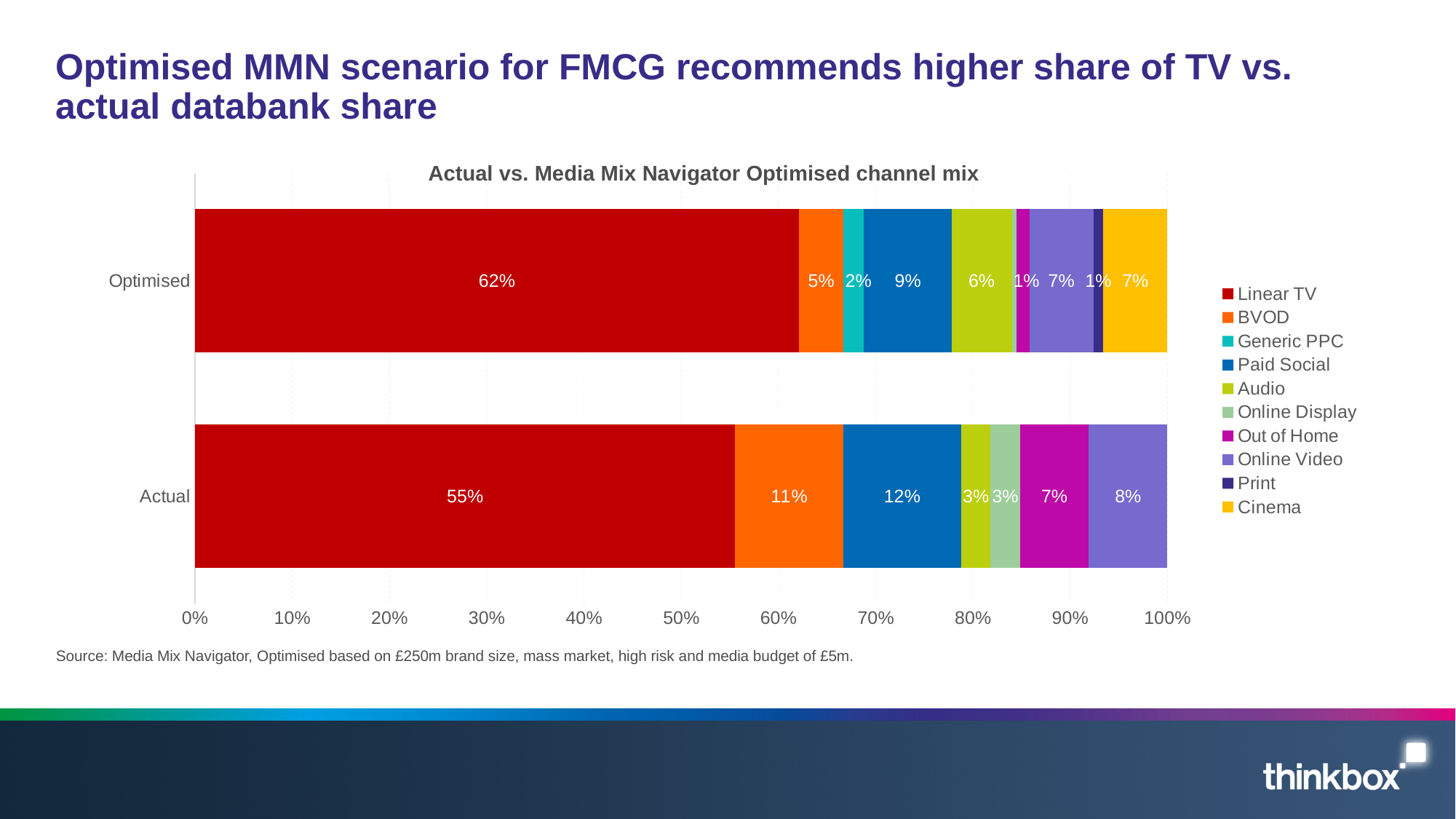
What kind of chart is shown on the slide? Stacked bar chart By how many percentage points does the Linear TV share in the Optimised bar exceed the Linear TV share in the Actual bar? 7 percentage points What share does Linear TV have in the Optimised bar? 62% Which bar has the larger BVOD share, Optimised or Actual? Actual How many series does the legend list? 10 What is the BVOD share in the Optimised bar? 5% What is the Cinema share in the Optimised bar? 7% How many bars (categories) are plotted on the chart? 2 What share does Linear TV have in the Actual bar? 55% What is the title of the chart? Actual vs. Media Mix Navigator Optimised channel mix Which channel has the largest share in the Actual bar? Linear TV What is the Paid Social share in the Actual bar? 12%